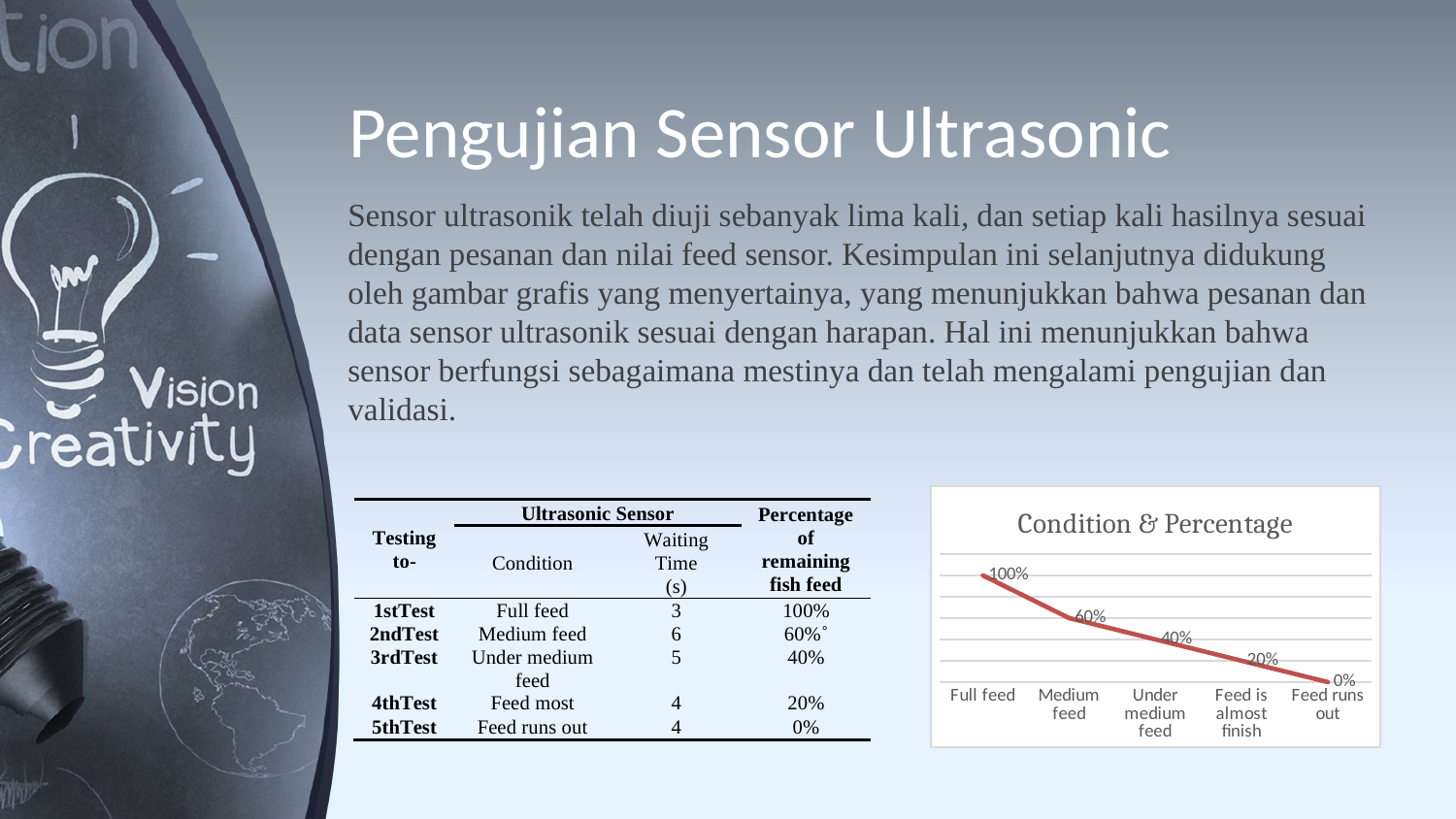
How many conditions are plotted along the x axis of the chart? 5 What is the percentage value for the Feed is almost finish condition in the chart? 20% What is the title of the chart on the slide? Condition & Percentage Which condition has the lowest percentage in the chart? Feed runs out What is the percentage value for the Medium feed condition in the chart? 60% What is the difference between the percentage for Under medium feed and the percentage for Feed is almost finish? 20% What is the difference between the percentage for Full feed and the percentage for Medium feed? 40% What kind of chart is shown on the slide? line chart What is the percentage value for the Under medium feed condition in the chart? 40% Which condition has the highest percentage in the chart? Full feed Do the percentage values rise or fall from left to right along the x axis of the chart? fall Which has a larger percentage in the chart, Medium feed or Feed is almost finish? Medium feed